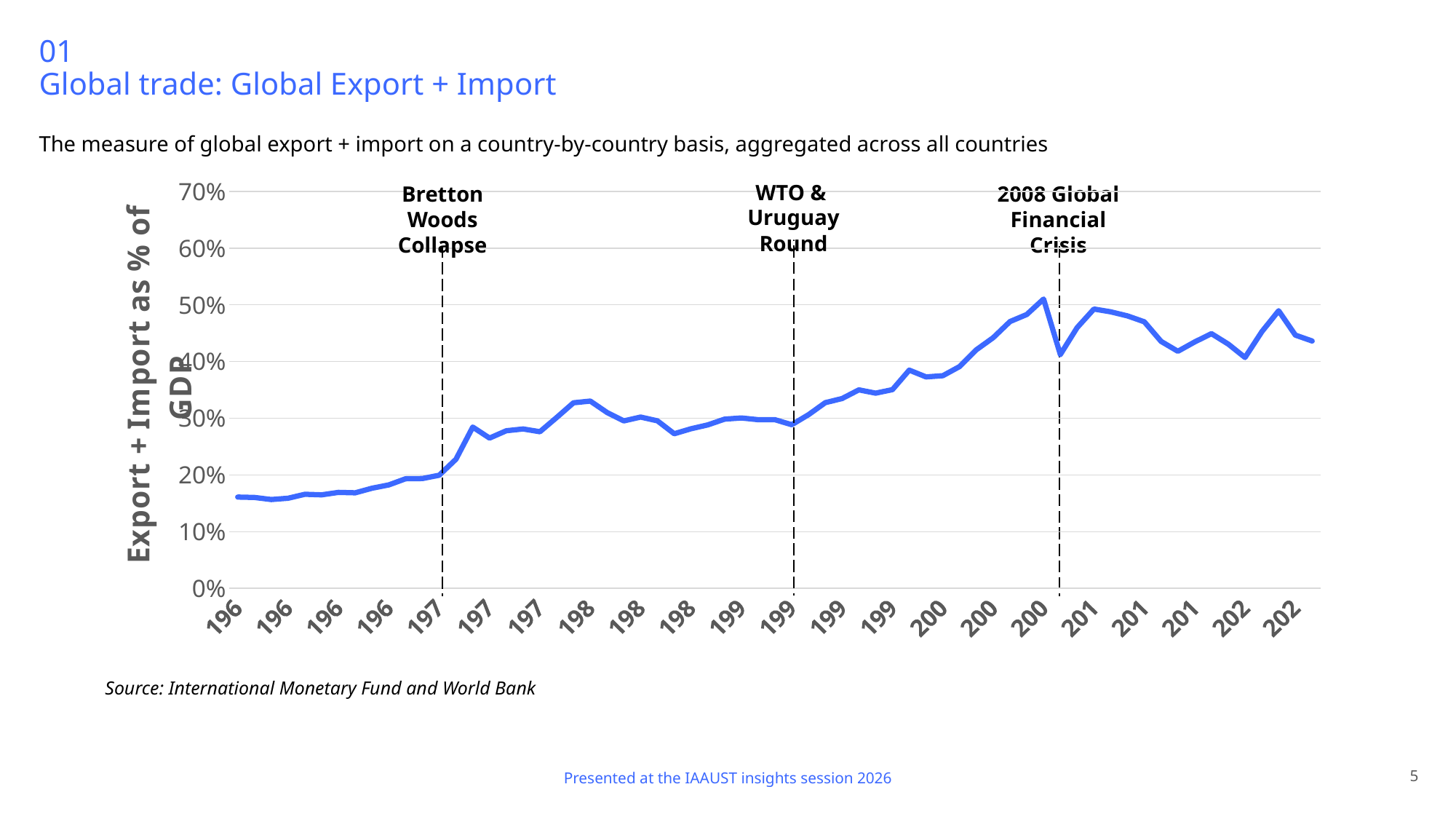
Where on the chart does the line reach its lowest value: at the left-hand start, at the Bretton Woods Collapse line, or at the 2008 Global Financial Crisis line? At the left-hand start Overall, does the Export + Import as % of GDP line rise or fall from the left of the chart to the right? Rise Is the value at the left-hand start of the line greater or less than 20%? less What kind of chart is shown on the slide? Line chart What is the title of the vertical axis? Export + Import as % of GDP Is the peak reached just before the 2008 Global Financial Crisis dashed line greater or less than 40%? greater Is the value at the Bretton Woods Collapse dashed line larger or smaller than the value at the WTO & Uruguay Round dashed line? Smaller Which three events are marked with dashed vertical lines on the chart? Bretton Woods Collapse, WTO & Uruguay Round, 2008 Global Financial Crisis How many data series are plotted on the chart? 1 Is the value at the right-hand end of the line greater or less than 40%? greater Does the line rise or fall immediately after the 2008 Global Financial Crisis dashed line? Rise